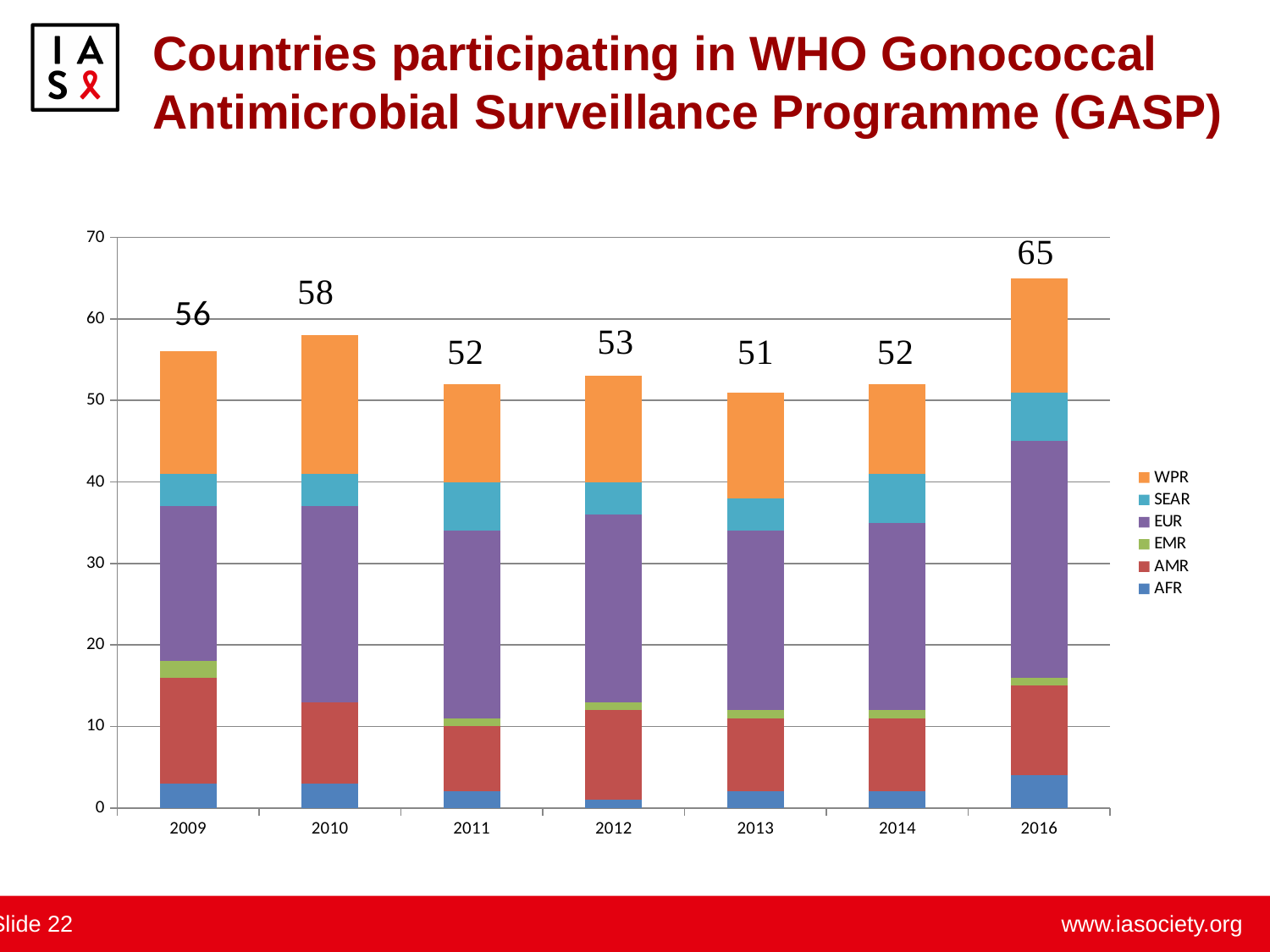
Is the AFR value for 2016 greater or less than 10? less What is the total number of countries shown for 2013? 51 Which year has the highest total number of participating countries? 2016 What is the difference between the total for 2016 and the total for 2009? 9 How many years are shown on the x axis? 7 What is the total number of countries shown for 2009? 56 Which year has a larger total, 2010 or 2012? 2010 Which year has the lowest total number of participating countries? 2013 What is the total number of countries shown for 2016? 65 What is the difference between the total for 2010 and the total for 2011? 6 What kind of chart is shown on the slide? Stacked bar chart How many series does the legend list? 6